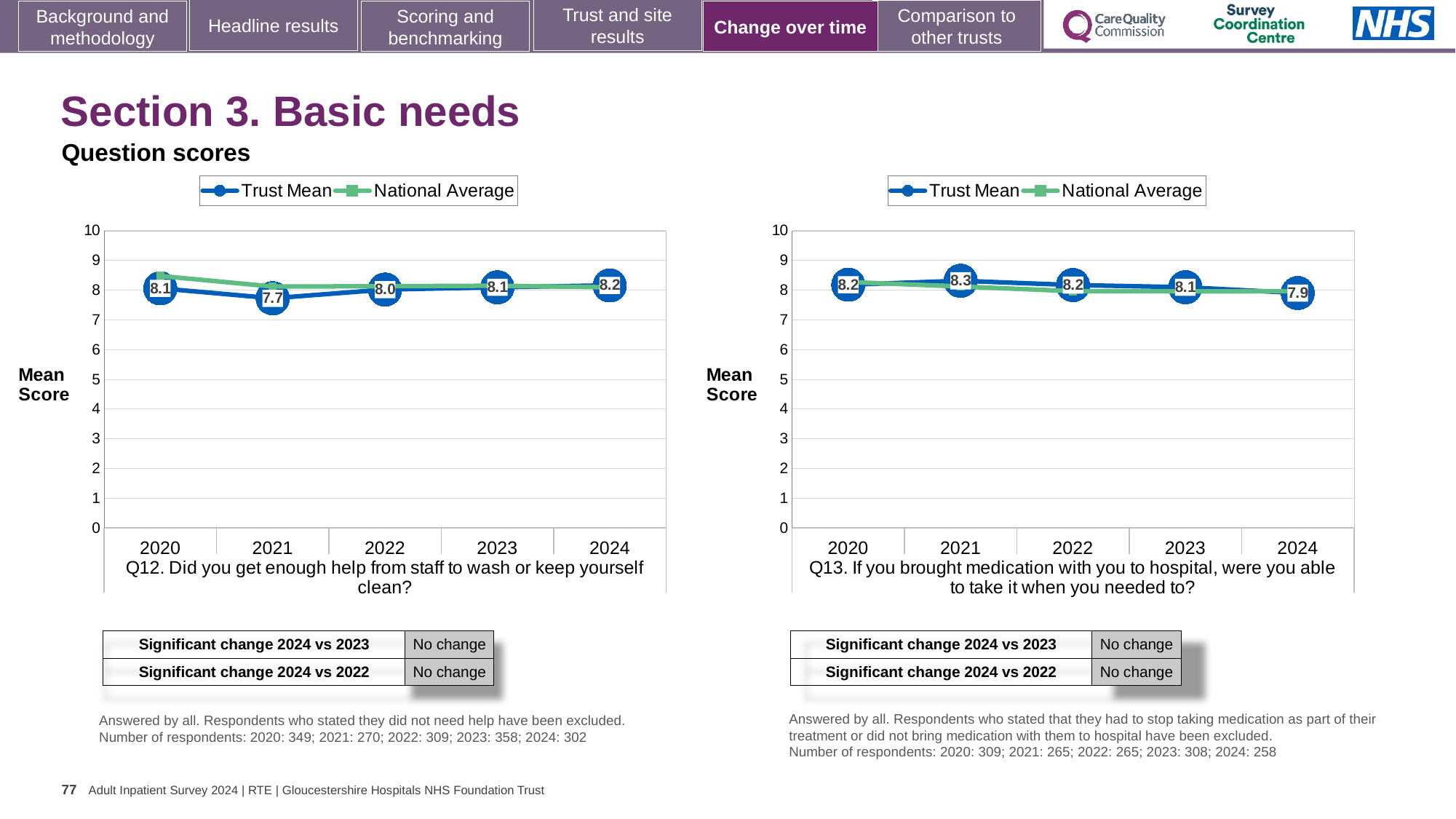
What type of chart is used for Q12 (left)? Line chart On the Q12 chart (left), which year has the lowest Trust Mean score? 2021 How many series does the legend of the Q13 chart (right) list? 2 On the Q13 chart (right), what is the Trust Mean score for 2021? 8.3 How many years are plotted on the x axis of the Q12 chart (left)? 5 On the Q13 chart (right), is the Trust Mean score for 2020 larger or smaller than the Trust Mean score for 2024? larger On the Q13 chart (right), what is the difference between the Trust Mean scores for 2021 and 2024? 0.4 On the Q13 chart (right), which year has the highest Trust Mean score? 2021 On the Q13 chart (right), what is the Trust Mean score for 2024? 7.9 On the Q12 chart (left), what is the difference between the Trust Mean scores for 2024 and 2021? 0.5 On the Q12 chart (left), what is the Trust Mean score for 2021? 7.7 On the Q12 chart (left), what is the Trust Mean score for 2024? 8.2